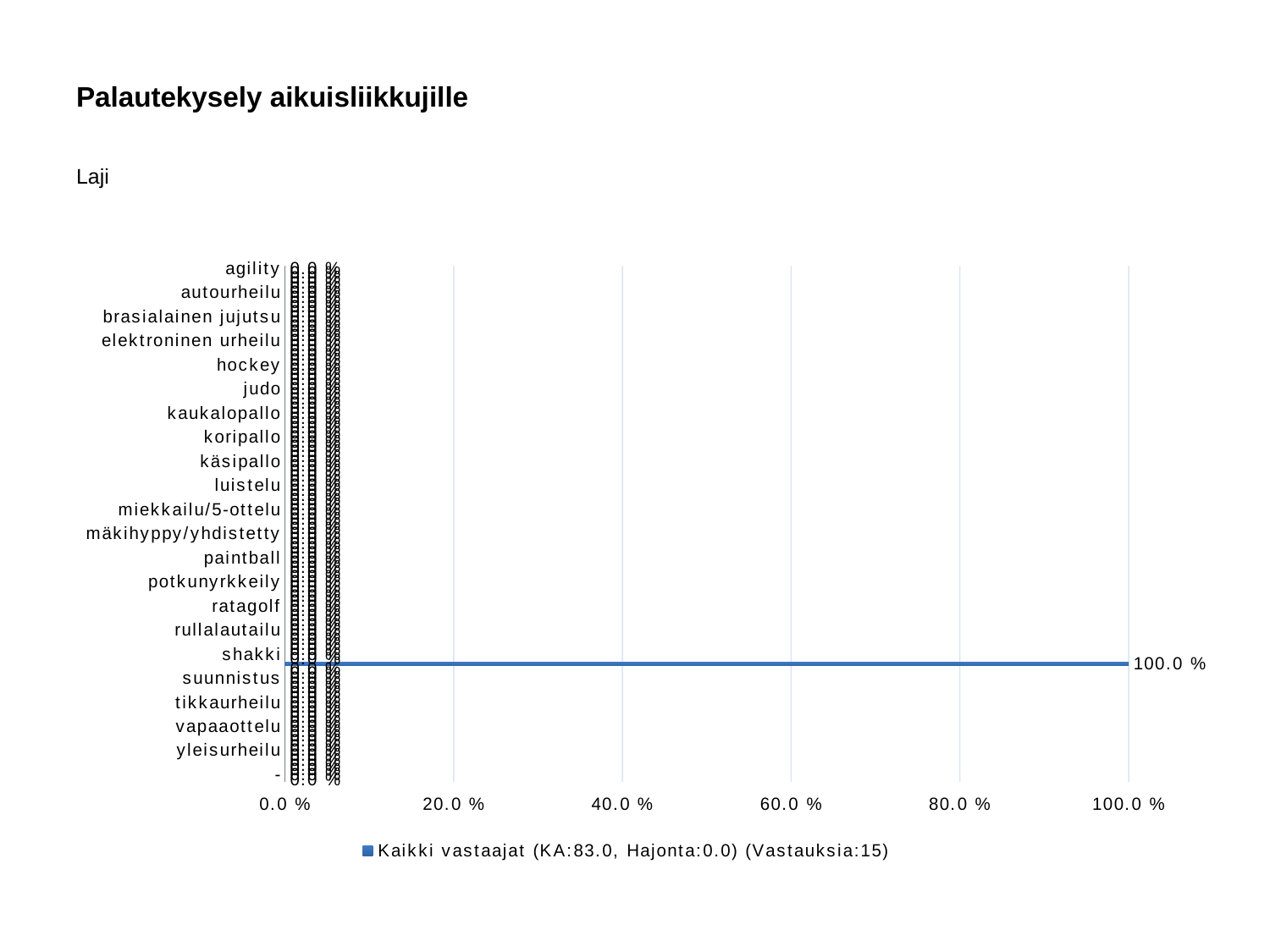
What is the title of the slide? Palautekysely aikuisliikkujille What is the maximum value shown on the horizontal axis? 100.0 % How many series does the legend list? 1 Is the value for judo greater or less than 40.0 %? less Is the value for hockey greater or less than 60.0 %? less What is the highest value shown in the chart? 100.0 % What type of chart is shown on the slide? bar chart Is the value for yleisurheilu greater or less than 20.0 %? less What is the legend entry for the series? Kaikki vastaajat (KA:83.0, Hajonta:0.0) (Vastauksia:15)